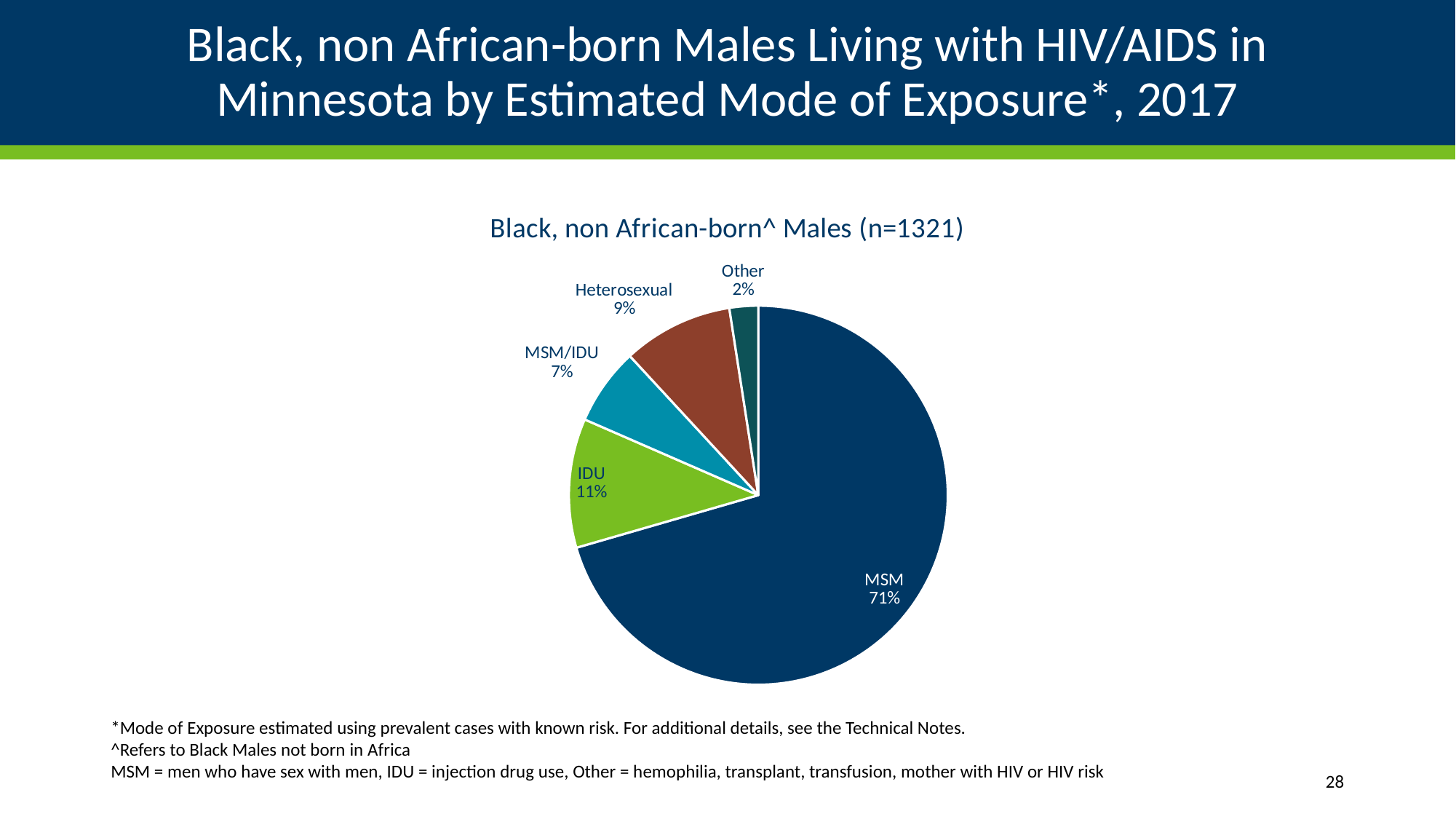
How many slices does the pie chart have? 5 What percentage is shown for MSM/IDU? 7% What share of the pie does MSM account for? 71% What is the n value given in the chart title? 1321 What percentage is shown for IDU? 11% What is the difference in percentage points between IDU and Heterosexual? 2 Which mode of exposure has the smallest slice? Other Which mode of exposure has the largest slice? MSM Which is larger, the share for MSM/IDU or the share for Heterosexual? Heterosexual What type of chart is shown on the slide? pie chart What percentage is shown for Heterosexual? 9% What percentage is shown for Other? 2%